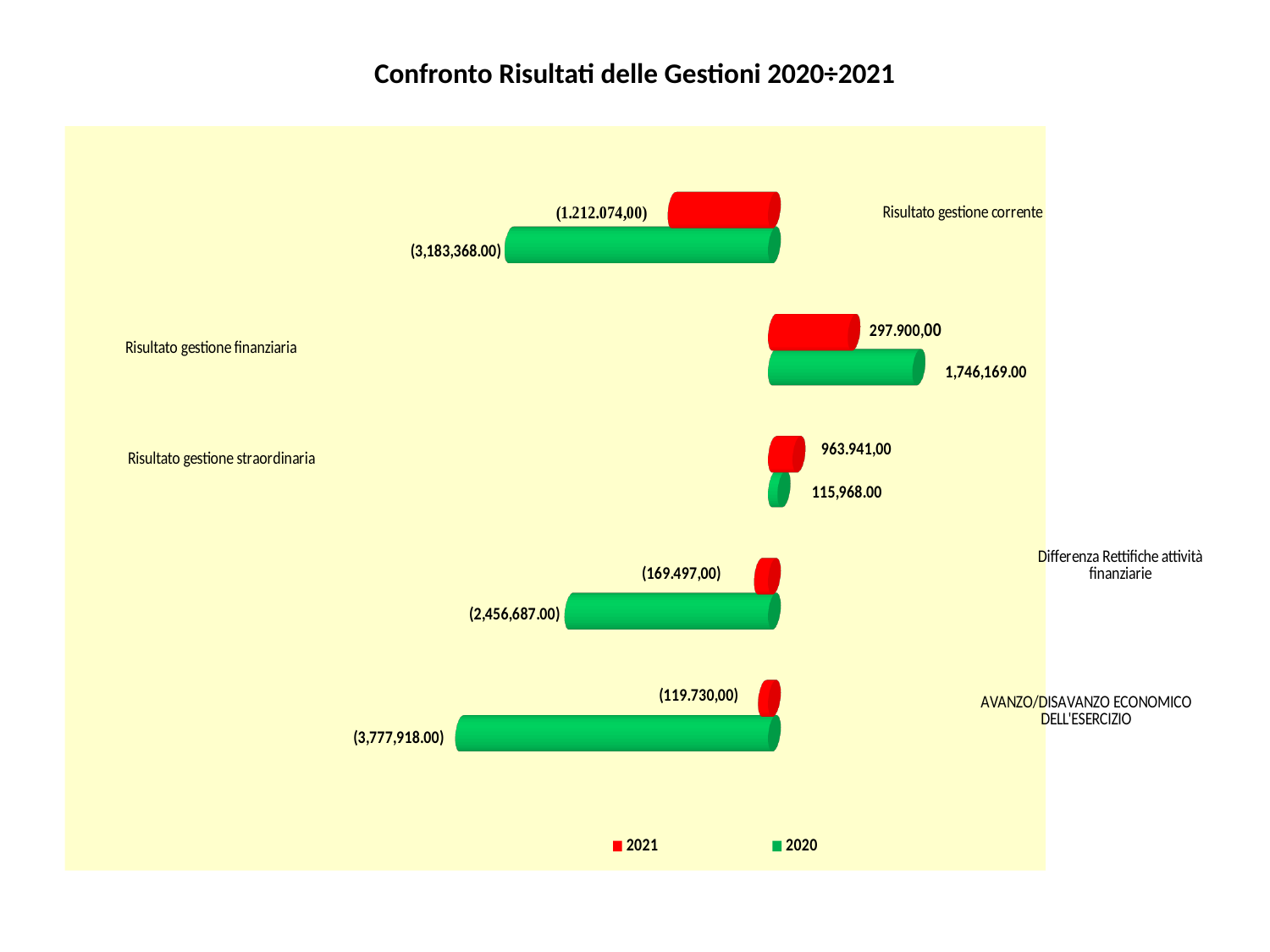
What is the 2020 value for Risultato gestione straordinaria? 115,968.00 What is the difference between the 2021 values for Risultato gestione straordinaria and Risultato gestione finanziaria? 666.041,00 What is the 2020 value for Differenza Rettifiche attività finanziarie? (2,456,687.00) For Risultato gestione straordinaria, which year has the larger value, 2020 or 2021? 2021 What is the 2020 value for Risultato gestione corrente? (3,183,368.00) How many series does the legend list? 2 What is the 2021 value for AVANZO/DISAVANZO ECONOMICO DELL'ESERCIZIO? (119.730,00) How many categories are shown in the chart? 5 Which category has the highest 2020 value? Risultato gestione finanziaria Which category has the lowest 2020 value? AVANZO/DISAVANZO ECONOMICO DELL'ESERCIZIO